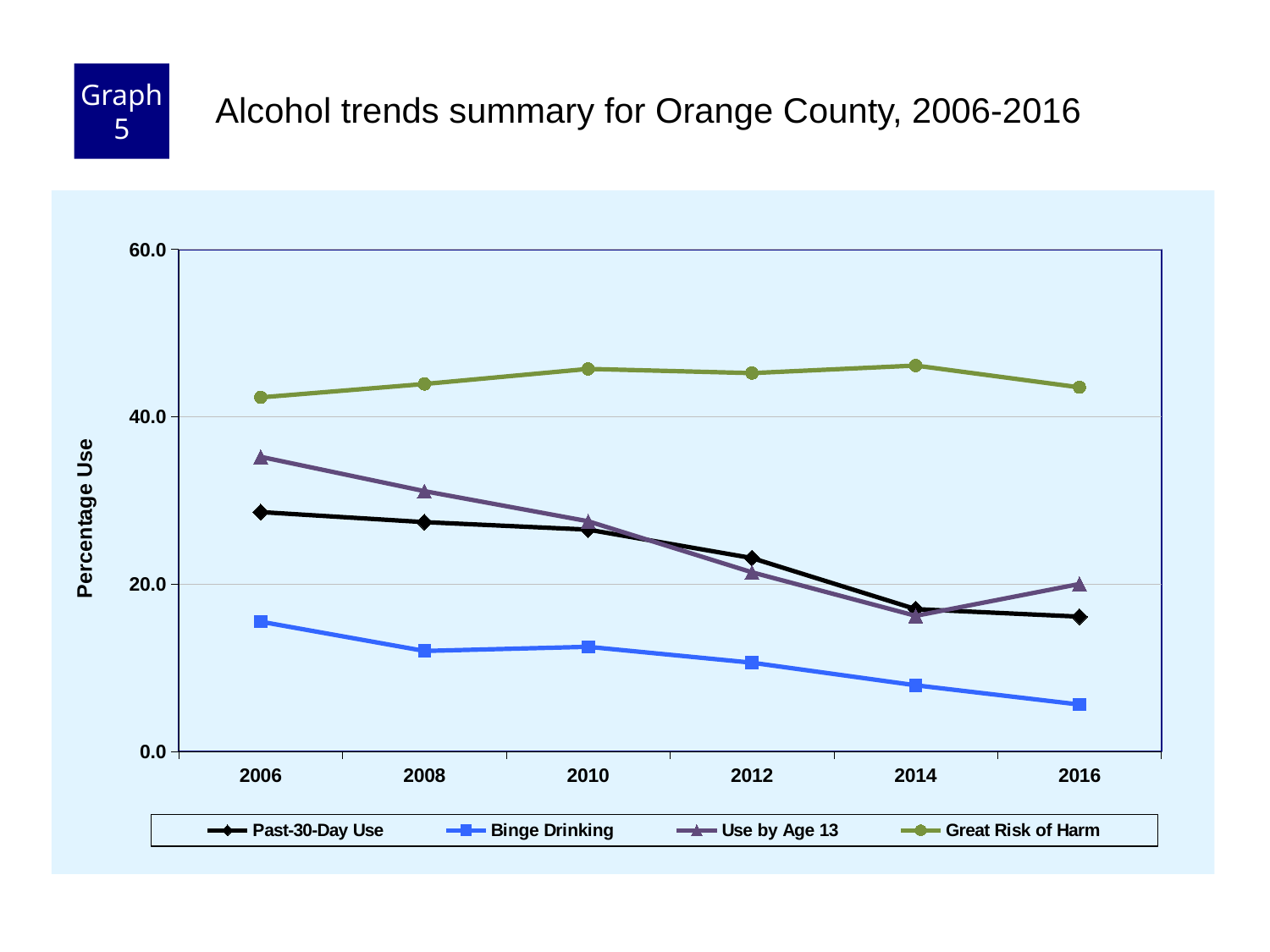
Is the value for Binge Drinking in 2016 greater or less than 20.0? less Is the value for Use by Age 13 in 2006 greater or less than 40.0? less What is the label on the y axis? Percentage Use What kind of chart is shown on the slide? Line chart Is the value for Great Risk of Harm in 2010 greater or less than 40.0? greater In 2006, which is larger: Use by Age 13 or Past-30-Day Use? Use by Age 13 What is the title of the slide's chart? Alcohol trends summary for Orange County, 2006-2016 How many series does the legend list? 4 How many years are plotted along the x axis? 6 Which series has the highest value in 2012? Great Risk of Harm Does the Binge Drinking series rise or fall from 2006 to 2016? Fall Which series has the lowest value in 2014? Binge Drinking